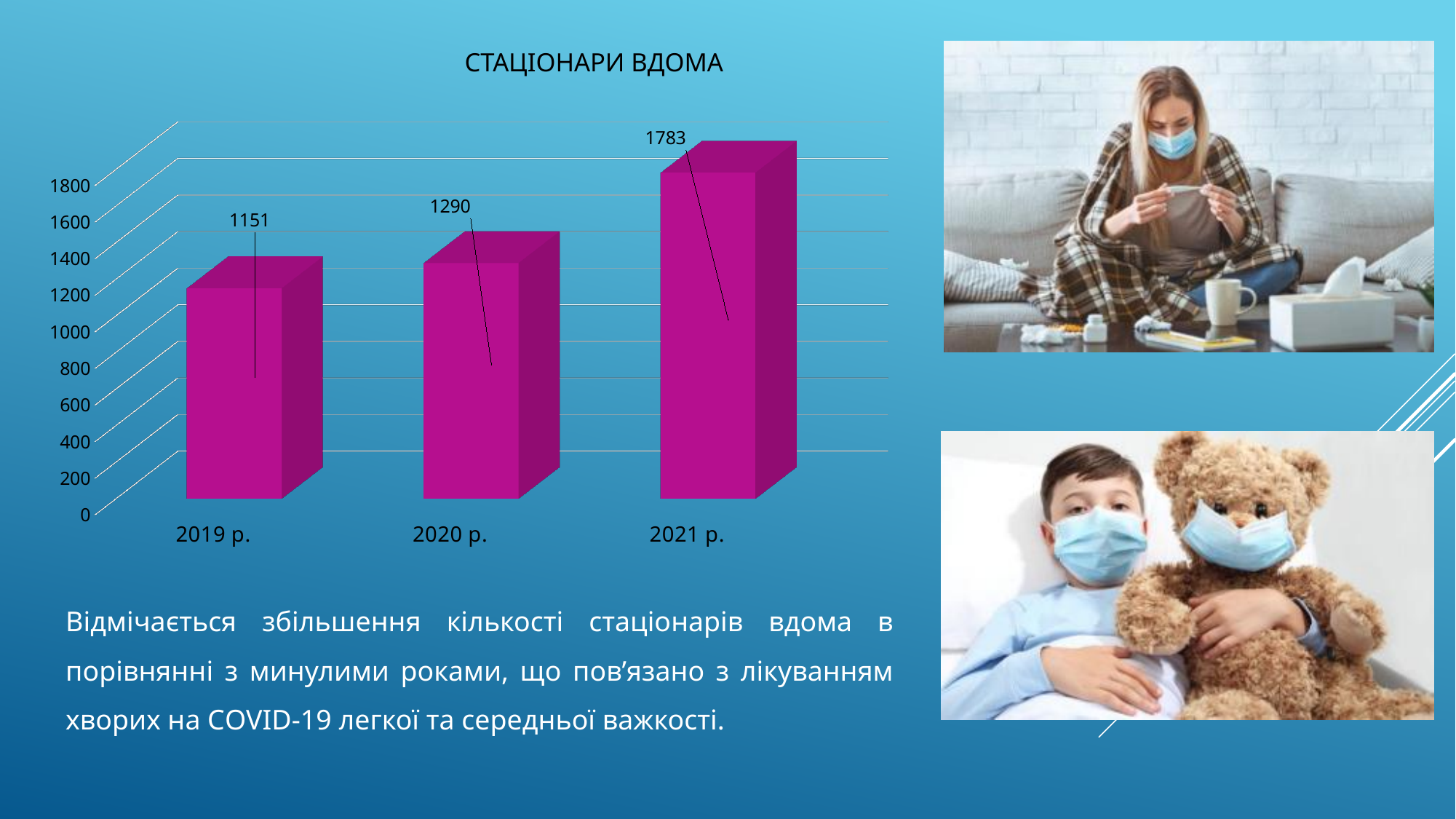
Do the values rise or fall from 2019 р. to 2021 р.? rise What is the difference between the values for 2020 р. and 2019 р.? 139 Which year has the lowest value in the chart? 2019 р. What is the value for 2019 р. in the chart? 1151 What kind of chart is shown on the slide? bar chart Is the value for 2021 р. greater or less than 1600? greater Which is larger, the value for 2019 р. or the value for 2020 р.? 2020 р. Which year has the highest value in the chart? 2021 р. What is the value for 2021 р. in the chart? 1783 What is the value for 2020 р. in the chart? 1290 How many years are shown in the chart? 3 What is the difference between the values for 2021 р. and 2020 р.? 493